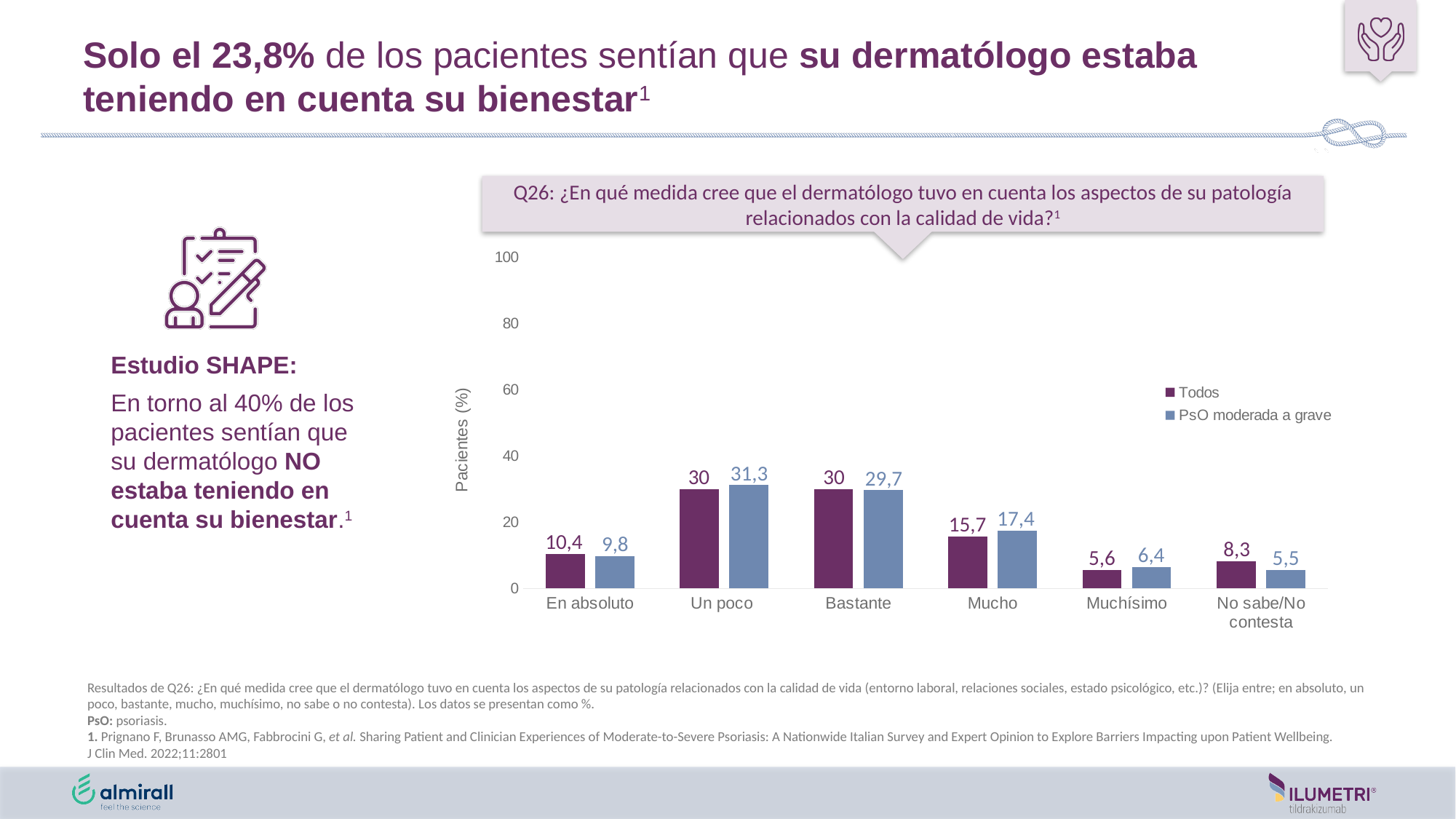
What is the difference between the 'PsO moderada a grave' and 'Todos' values in the 'Mucho' category? 1,7 Is the value for 'Todos' in the 'Un poco' category greater or less than 20? greater What is the value for 'Todos' in the 'No sabe/No contesta' category? 8,3 How many categories are shown on the x axis of the chart? 6 What is the label of the y axis of the chart? Pacientes (%) Which category has the lowest value for the 'Todos' series? Muchísimo In the 'No sabe/No contesta' category, which series has the larger value, 'Todos' or 'PsO moderada a grave'? Todos What is the value for 'Todos' in the 'En absoluto' category? 10,4 What type of chart is shown on the slide? Bar chart How many series does the chart legend list? 2 What is the value for 'PsO moderada a grave' in the 'Mucho' category? 17,4 Which category has the highest value for the 'PsO moderada a grave' series? Un poco